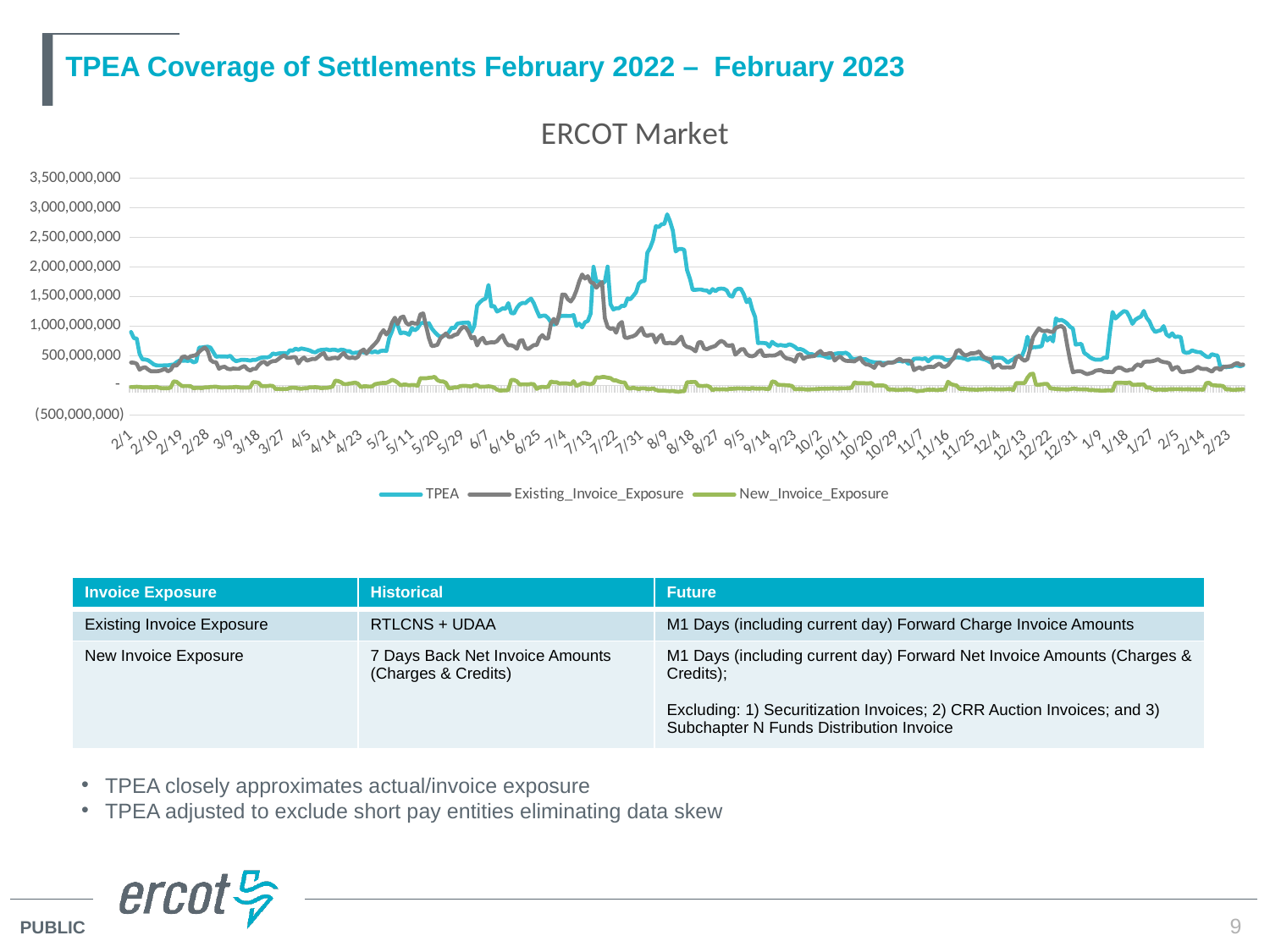
What is the title of the chart? ERCOT Market Is the highest value of the New_Invoice_Exposure line greater or less than 500,000,000? less Is the peak value of the TPEA line greater or less than 2,500,000,000? greater What kind of chart is shown on the slide? line chart Does the TPEA line rise or fall between 8/9 and 9/23? fall Around 8/9, which series is higher, TPEA or Existing_Invoice_Exposure? TPEA Is the Existing_Invoice_Exposure value around 10/2 greater or less than 1,000,000,000? less What is the highest value shown on the chart's vertical axis? 3,500,000,000 What colour is the TPEA line in the chart? blue How many series does the chart legend list? 3 Which series reaches the highest peak in the chart? TPEA Which series stays lowest across the whole chart? New_Invoice_Exposure